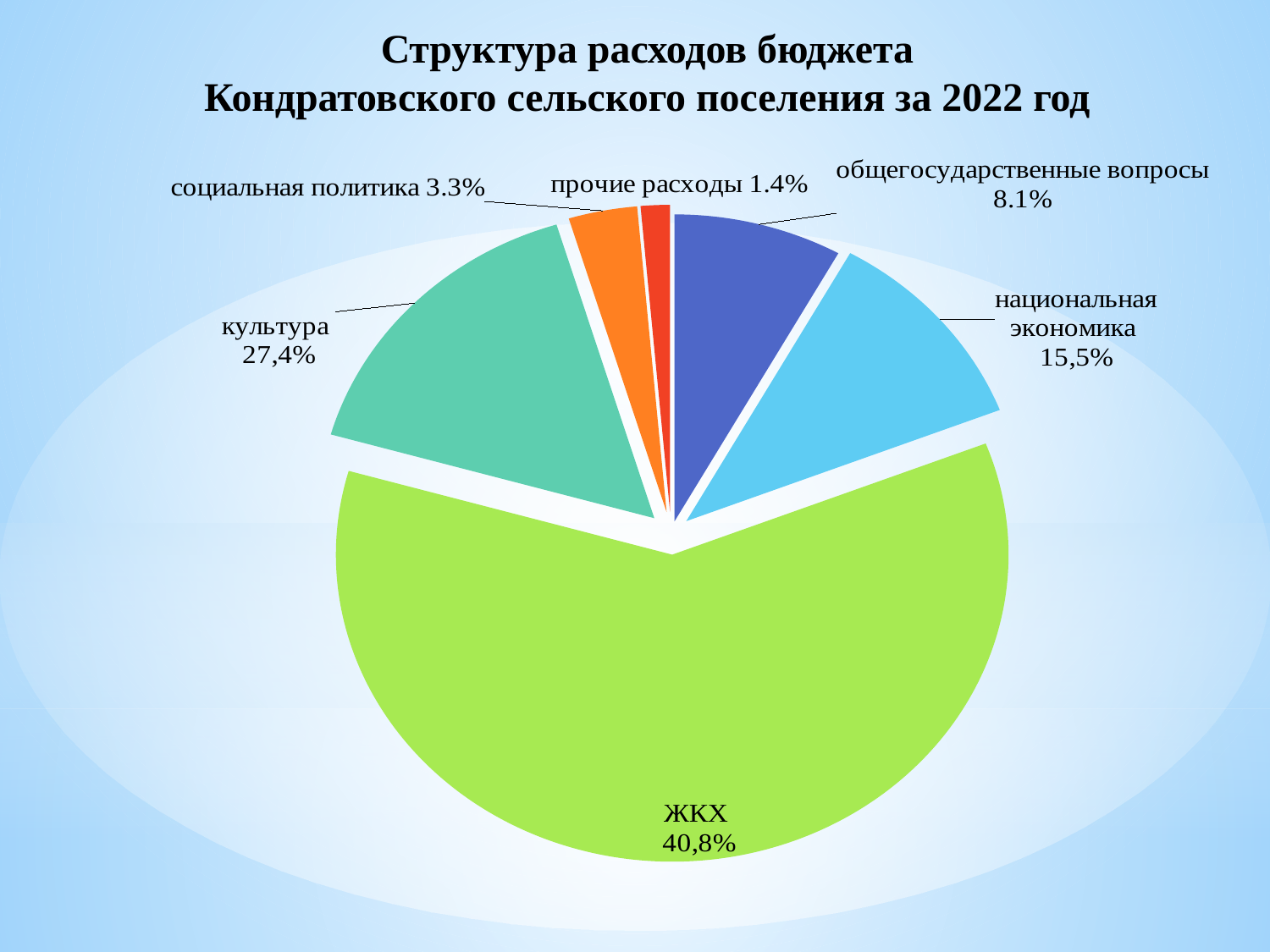
Which is larger, the share of национальная экономика or the share of социальная политика? национальная экономика What is the difference between the shares of ЖКХ and культура? 13,4% What is the title of the chart? Структура расходов бюджета Кондратовского сельского поселения за 2022 год What share of the budget expenses is культура? 27,4% What share of the budget expenses is национальная экономика? 15,5% Which category has the largest share of the budget expenses? ЖКХ What share of the budget expenses is прочие расходы? 1.4% How many slices does the pie chart have? 6 What share of the budget expenses is общегосударственные вопросы? 8.1% What share of the budget expenses is ЖКХ? 40,8% What kind of chart is shown on the slide? pie chart Which category has the smallest share of the budget expenses? прочие расходы